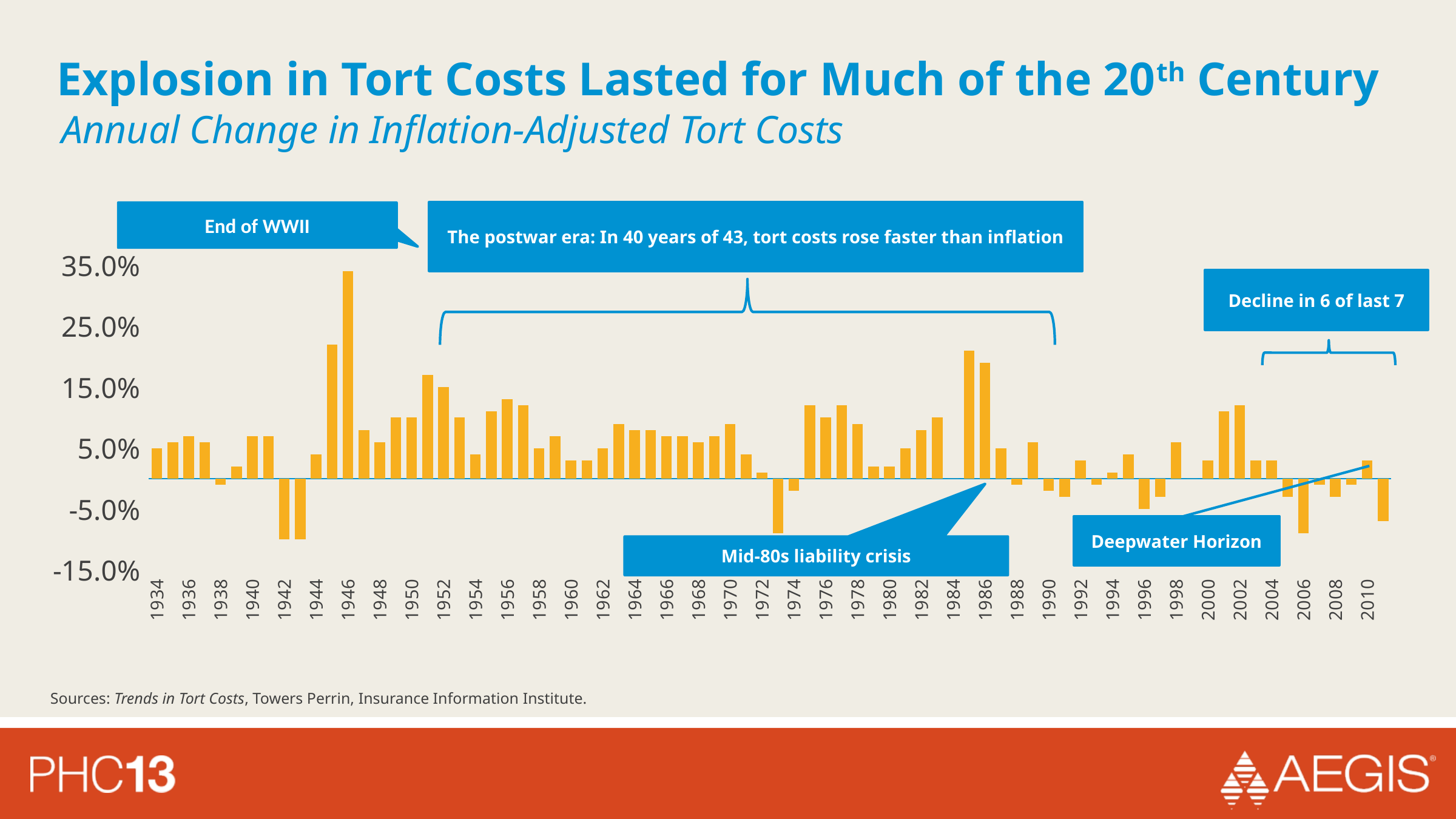
Which year has the larger value, 1934 or 1942? 1934 Is the value for 1985 greater or less than 15.0%? greater Is the value for 1946 greater or less than 25.0%? greater Is the value for 2006 greater or less than -5.0%? less According to the annotation on the chart, in how many of the last 7 years did tort costs decline? 6 Which year has the larger value, 1946 or 1985? 1946 From 1944 to 1946, do the values rise or fall? rise What kind of chart is shown on the slide? Bar chart Which year has the highest annual change in inflation-adjusted tort costs? 1946